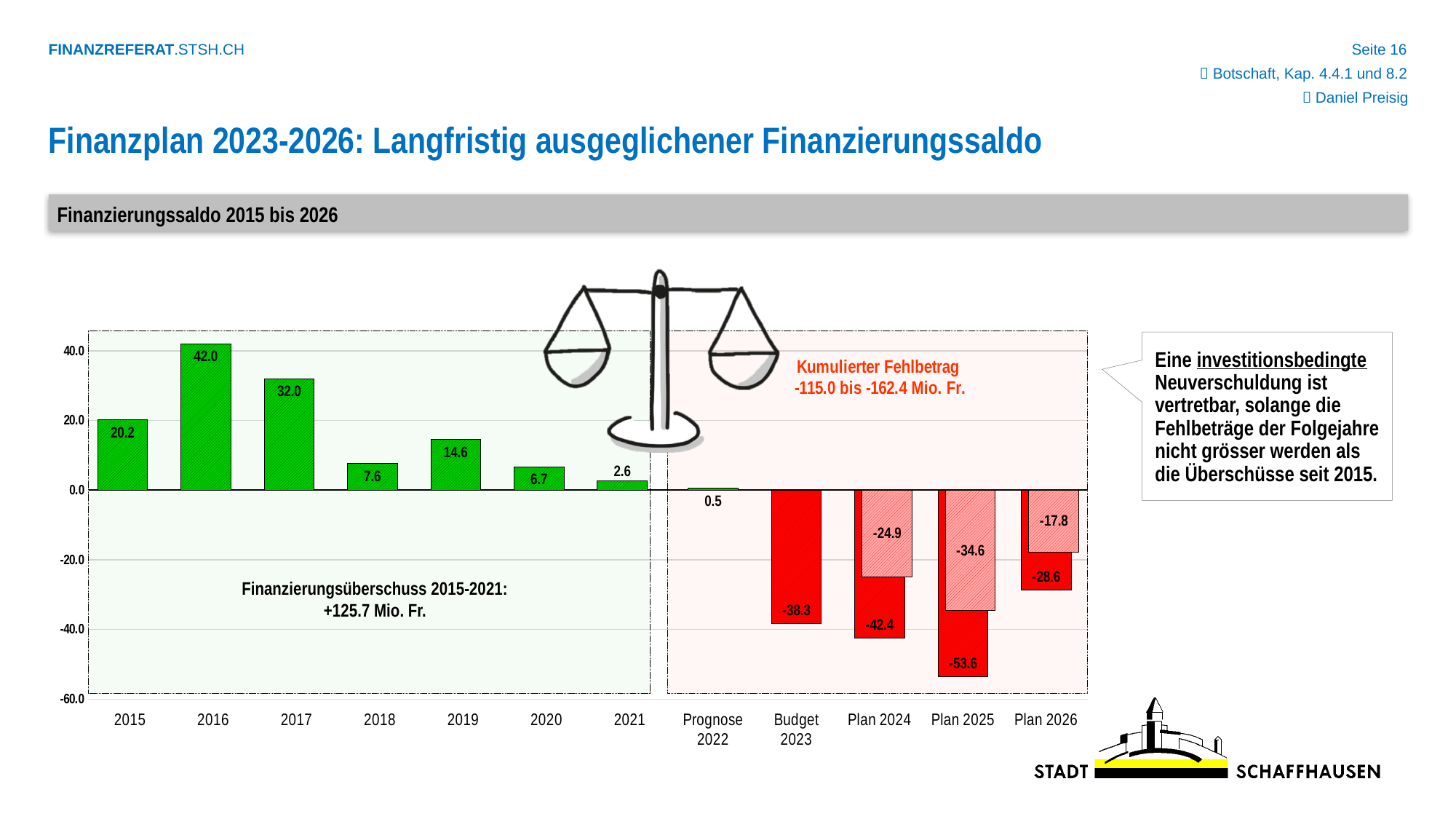
Which category has the lowest value? Plan 2025 What is the title of the chart? Finanzierungssaldo 2015 bis 2026 What is the value for 2019? 14.6 Which is larger, the value for 2018 or the value for 2020? 2018 What kind of chart is shown? Bar chart What is the value for Prognose 2022? 0.5 What is the difference between the values for 2016 and 2017? 10.0 What is the lower (darker red) value shown for Plan 2025? -53.6 Which year has the highest value? 2016 What is the value for Budget 2023? -38.3 What is the value for 2016? 42.0 How many categories are shown on the x axis? 12